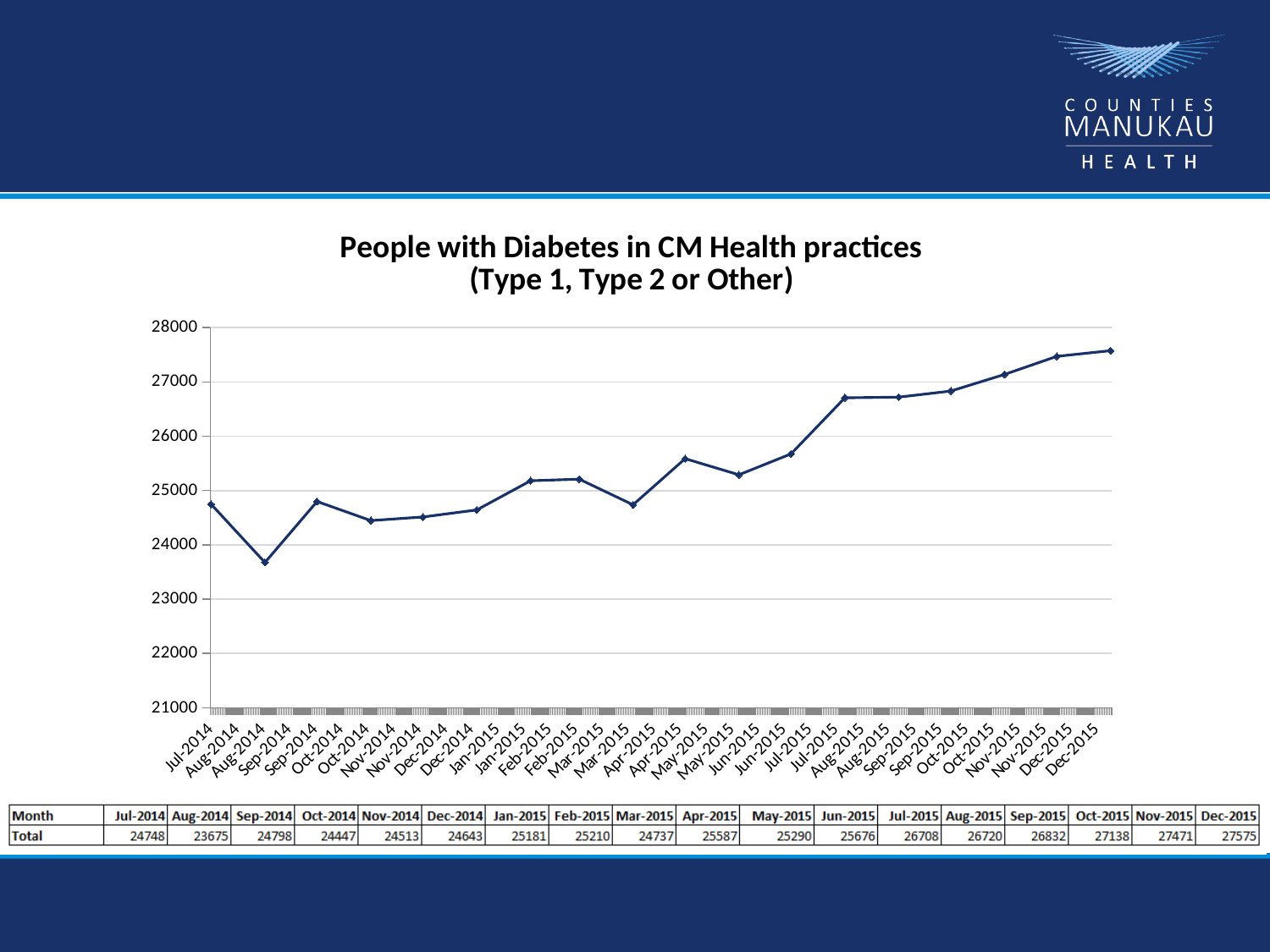
What is the difference between the totals for Dec-2015 and Aug-2014? 3900 How many months are plotted on the chart? 18 What is the title of the chart? People with Diabetes in CM Health practices (Type 1, Type 2 or Other) What is the total for Aug-2014? 23675 What type of chart is shown on the slide? line chart Which month has the highest total? Dec-2015 What is the total for Jul-2015? 26708 Which is larger, the total for Apr-2015 or the total for May-2015? Apr-2015 Is the value for Oct-2015 greater or less than 27000? greater What is the difference between the totals for Jul-2015 and Jun-2015? 1032 Which month has the lowest total? Aug-2014 What is the total for Dec-2015? 27575